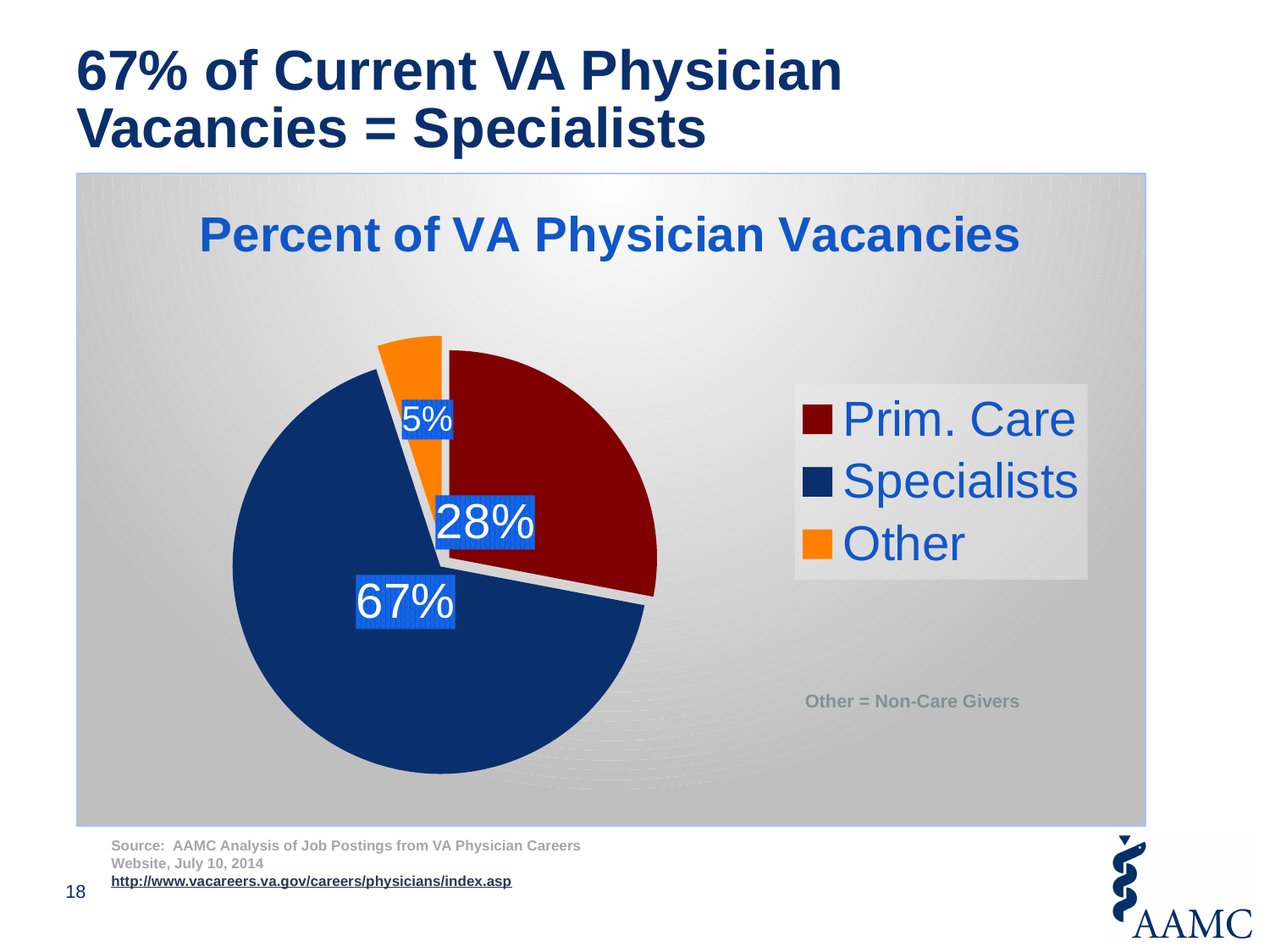
What colour is the Specialists slice? Dark blue How many categories does the legend list? 3 What percentage of VA physician vacancies are Prim. Care? 28% Which category has the smallest share of the pie? Other What is the difference in percentage points between Specialists and Prim. Care? 39 What is the title of the chart? Percent of VA Physician Vacancies What percentage of VA physician vacancies are Other? 5% Which is larger, the share for Prim. Care or the share for Other? Prim. Care Which category has the largest share of the pie? Specialists What kind of chart is shown on the slide? Pie chart How many slices does the pie chart have? 3 What percentage of VA physician vacancies are Specialists? 67%